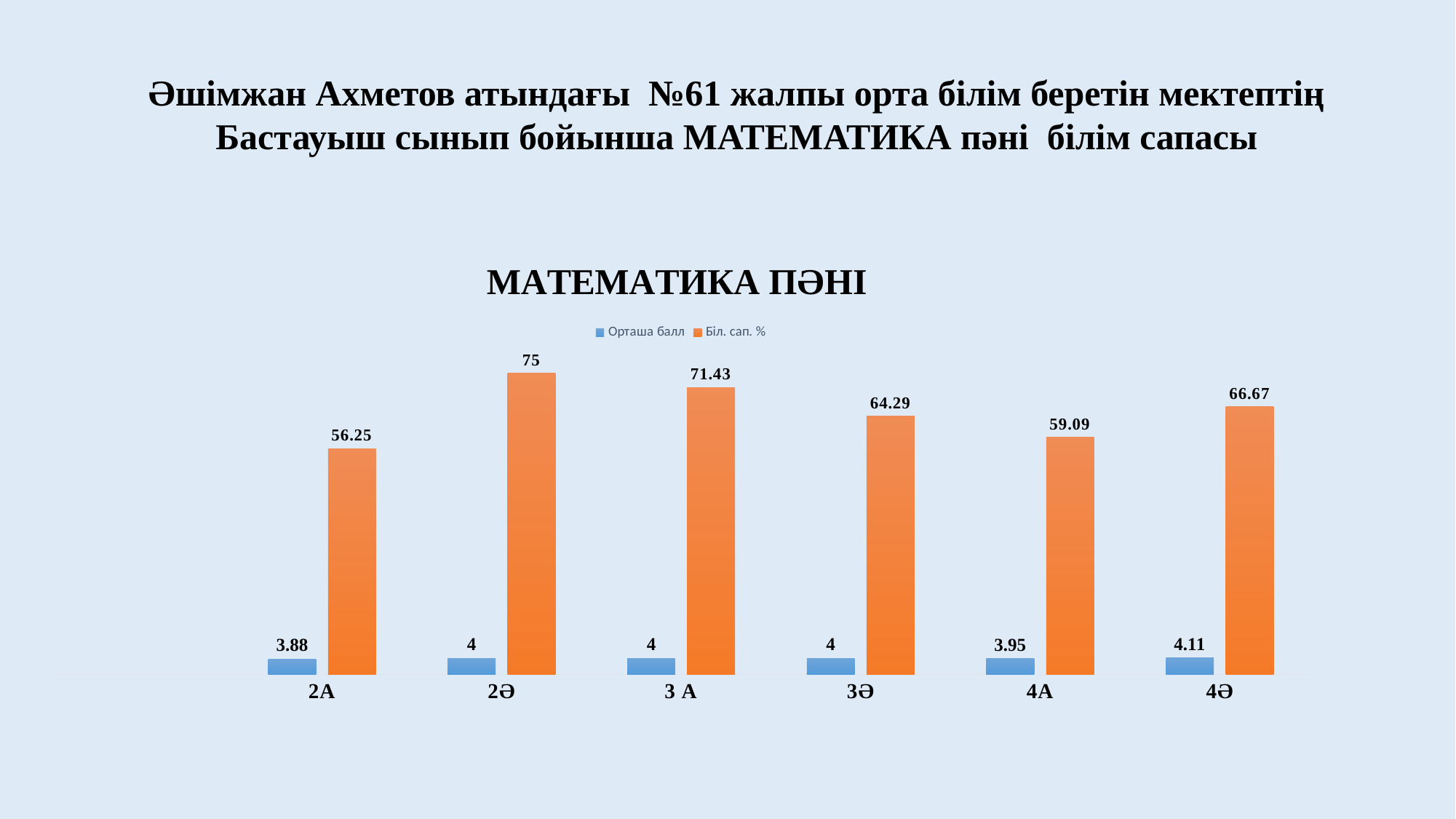
What kind of chart is shown? bar chart What is the difference between the Біл. сап. % values for 2Ә and 2А? 18.75 What is the Біл. сап. % value for 4А? 59.09 How many classes are shown on the x axis? 6 Which is larger, the Біл. сап. % value for 3 А or for 3Ә? 3 А Which class has the lowest Біл. сап. % value? 2А What is the title of the chart? МАТЕМАТИКА ПӘНІ Which class has the highest Біл. сап. % value? 2Ә Which class has the lowest Орташа балл value? 2А How many series does the legend list? 2 What is the Біл. сап. % value for 2Ә? 75 What is the Орташа балл value for 4Ә? 4.11